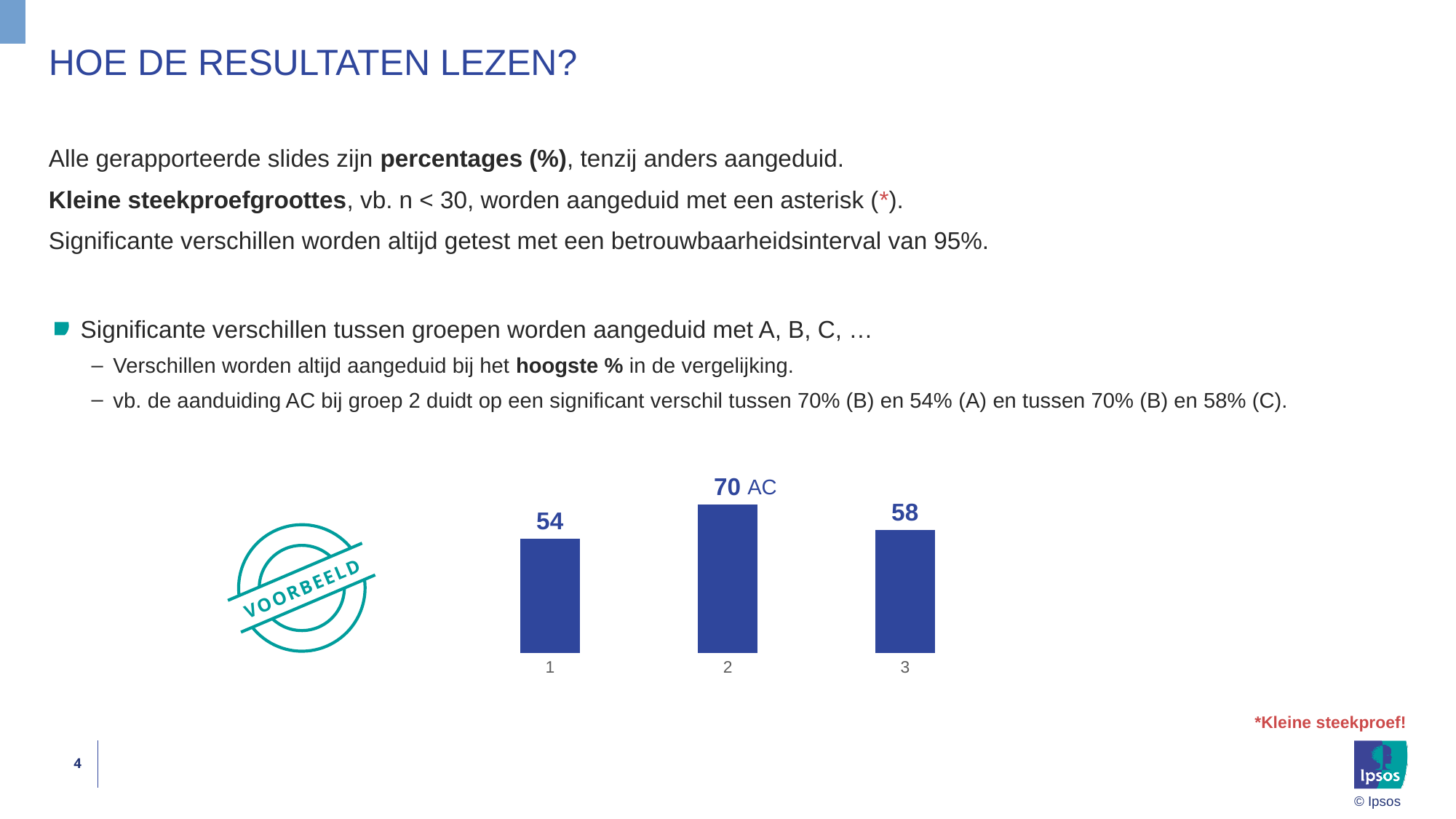
What is the difference between the values for category 3 and category 1? 4 What is the value for category 1? 54 What is the value for category 3? 58 What word is printed on the stamp to the left of the chart? VOORBEELD What kind of chart is shown on the slide? bar chart Which category has the lowest value? 1 What is the value for category 2? 70 How many bars are shown in the chart? 3 Which is larger, the value for category 2 or the value for category 3? 2 What is the difference between the values for category 2 and category 1? 16 Which category has the highest value? 2 Which significance letters are printed next to the value for category 2? AC